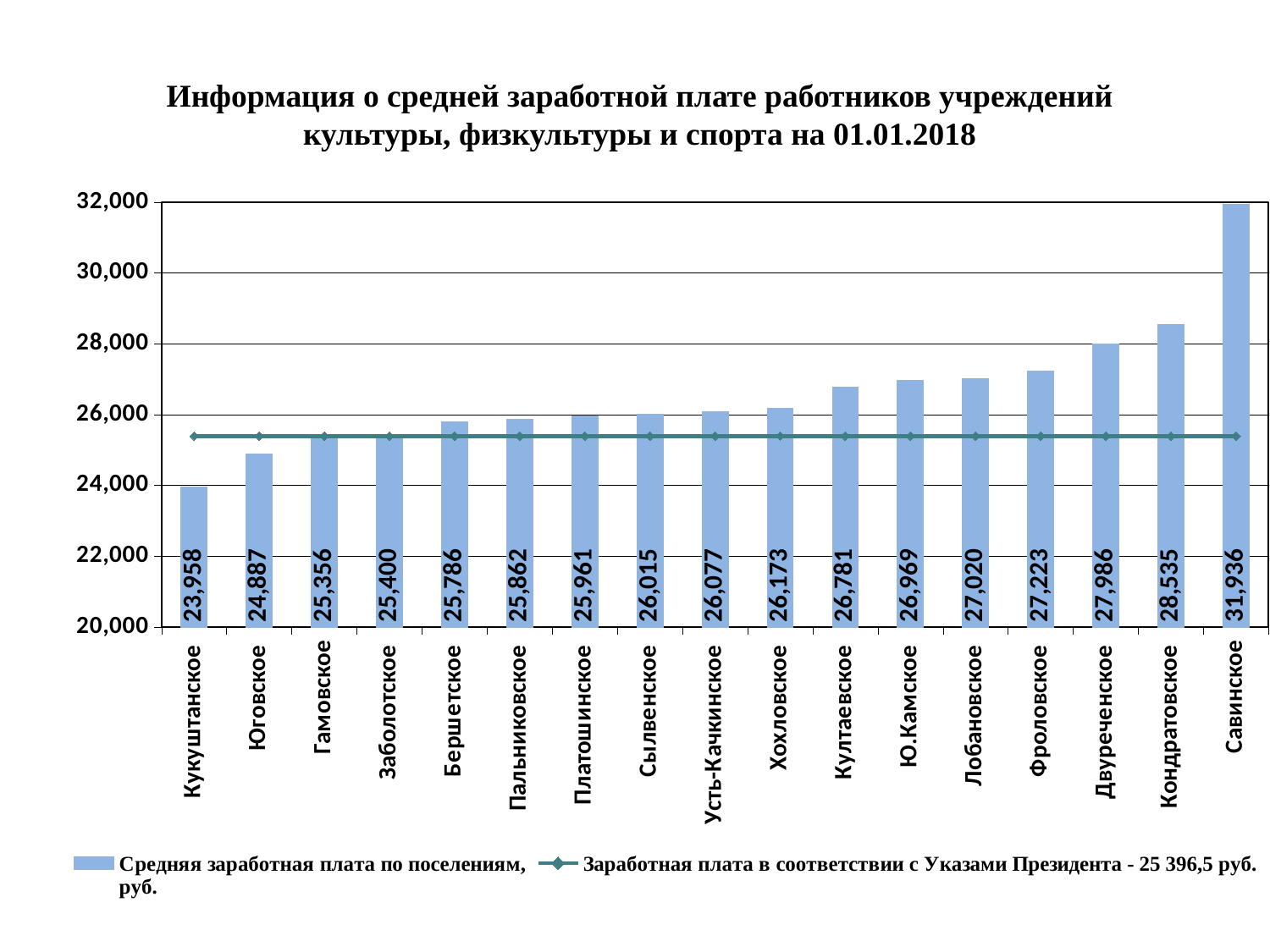
Which settlement has the highest average salary on the chart? Савинское How many settlements are shown on the x axis? 17 Which has a larger value, Фроловское or Хохловское? Фроловское What is the value shown for Лобановское? 27,020 What is the average salary value shown for Савинское? 31,936 Which settlement has the lowest average salary on the chart? Кукуштанское Is the value for Юговское greater or less than 26,000? less What is the value shown for Кукуштанское? 23,958 What is the difference between the values for Кондратовское and Двуреченское? 549 What kind of chart is used to show the average salary by settlement? bar chart What is the difference between the values for Савинское and Кукуштанское? 7,978 How many series does the legend list? 2